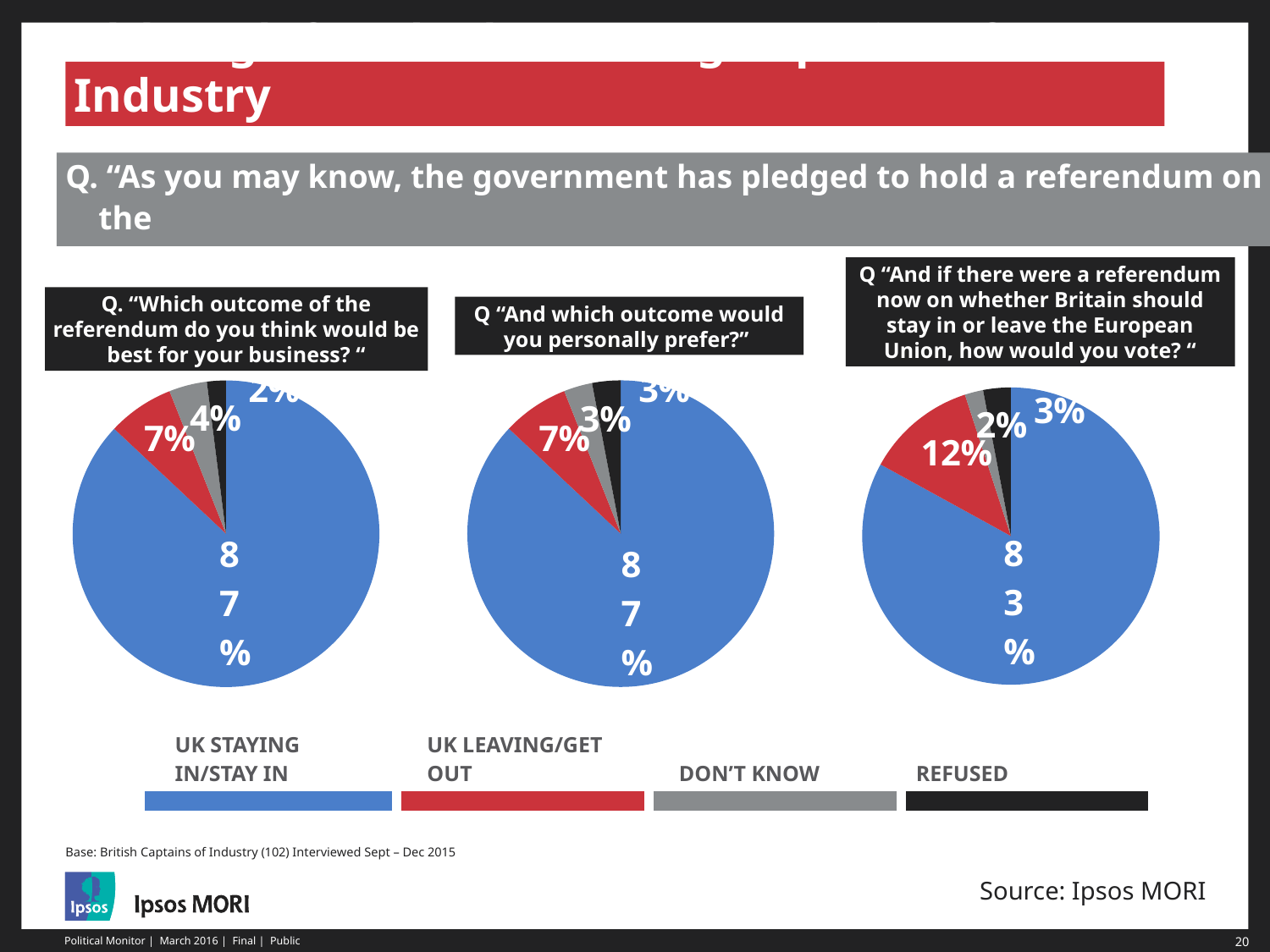
In the pie chart for "Which outcome of the referendum do you think would be best for your business?", what percentage is shown for UK staying in/stay in? 87% In the pie chart for "And if there were a referendum now...how would you vote?", what is the difference between the UK leaving/get out share and the refused share? 9 percentage points In the pie chart for "And if there were a referendum now...how would you vote?", what percentage is shown for UK staying in/stay in? 83% Which is larger: the UK leaving/get out share in the "best for your business" pie chart or the UK leaving/get out share in the "how would you vote" pie chart? The "how would you vote" pie chart In the pie chart for "And if there were a referendum now...how would you vote?", which category has the smallest share? Don't know In the pie chart for "And which outcome would you personally prefer?", what percentage is shown for UK leaving/get out? 7% In the pie chart for "Which outcome of the referendum do you think would be best for your business?", what percentage is shown for don't know? 4% What type of chart is used to show the responses on this slide? Pie chart In the pie chart for "And if there were a referendum now on whether Britain should stay in or leave the European Union, how would you vote?", what percentage is shown for UK leaving/get out? 12% In the pie chart for "And if there were a referendum now...how would you vote?", which category has the largest share? UK staying in/stay in What is the difference between the UK staying in/stay in share in the "best for your business" pie chart and the UK staying in/stay in share in the "how would you vote" pie chart? 4 percentage points How many categories does the legend list for the pie charts? 4